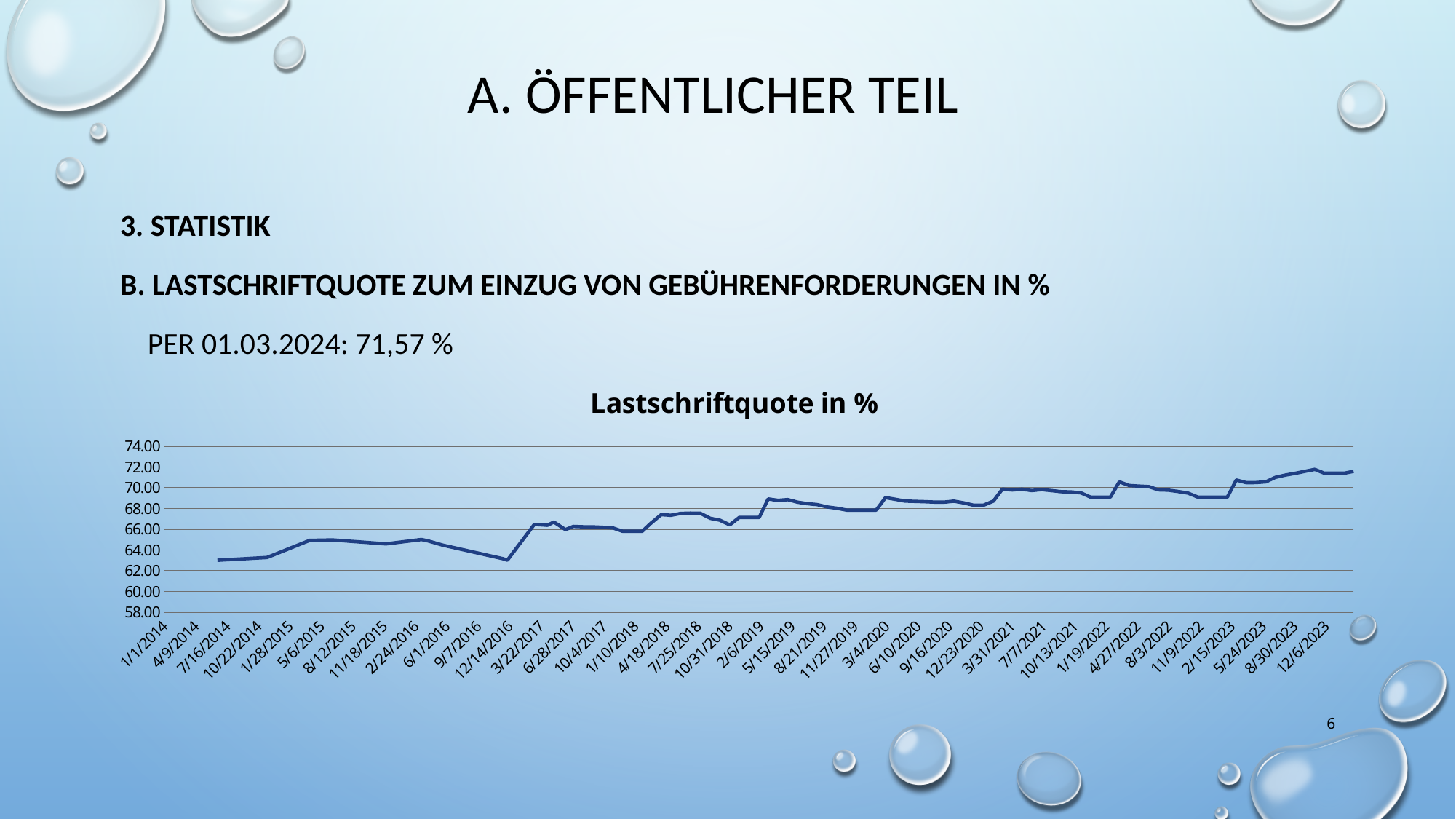
What is the title of the chart? Lastschriftquote in % Is the value for 9/7/2016 greater or less than 66.00? less Is the value for 3/31/2021 greater or less than 68.00? greater Which has the higher value, 7/16/2014 or 12/6/2023? 12/6/2023 Is the value for 12/14/2016 greater or less than 64.00? less What kind of chart is shown on the slide? line chart Do the values in the chart generally rise or fall from 2014 to 2023? rise Which has the higher value, 12/14/2016 or 3/22/2017? 3/22/2017 What is the highest value shown on the vertical axis of the chart? 74.00